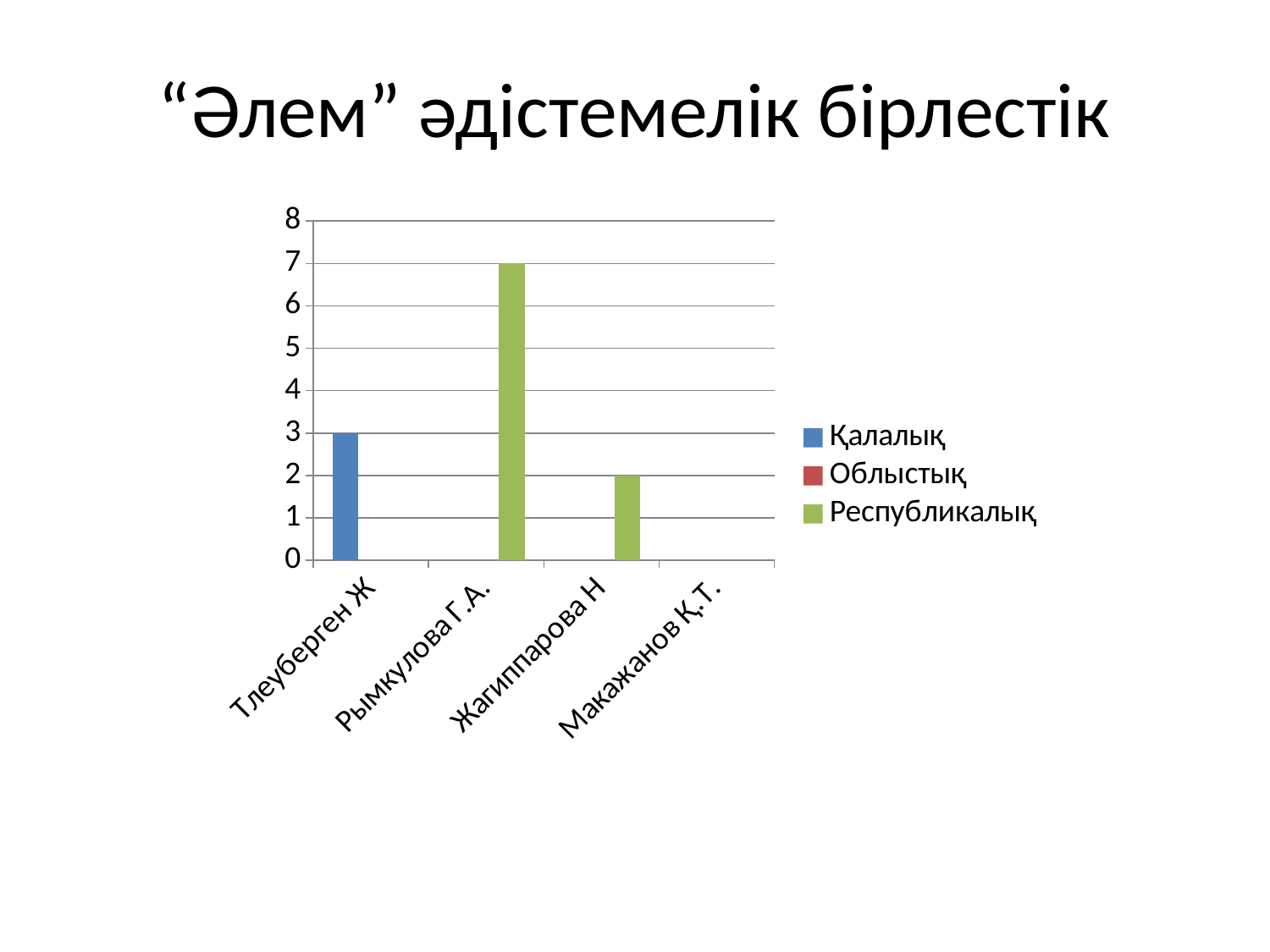
What is the difference between the Республикалық values for Рымкулова Г.А. and Жагиппарова Н? 5 What is the Республикалық value for Жагиппарова Н? 2 Which category has the tallest bar? Рымкулова Г.А. How many series does the legend list? 3 How many categories are shown on the x axis? 4 Is the Республикалық value for Рымкулова Г.А. greater or less than 5? greater What is the Қалалық value for Тлеуберген Ж? 3 What kind of chart is shown on the slide? bar chart Which is larger: the Қалалық value for Тлеуберген Ж or the Республикалық value for Жагиппарова Н? Қалалық value for Тлеуберген Ж Which colour represents the Республикалық series in the legend? green What is the title of the slide? “Әлем” әдістемелік бірлестік What is the Республикалық value for Рымкулова Г.А.? 7